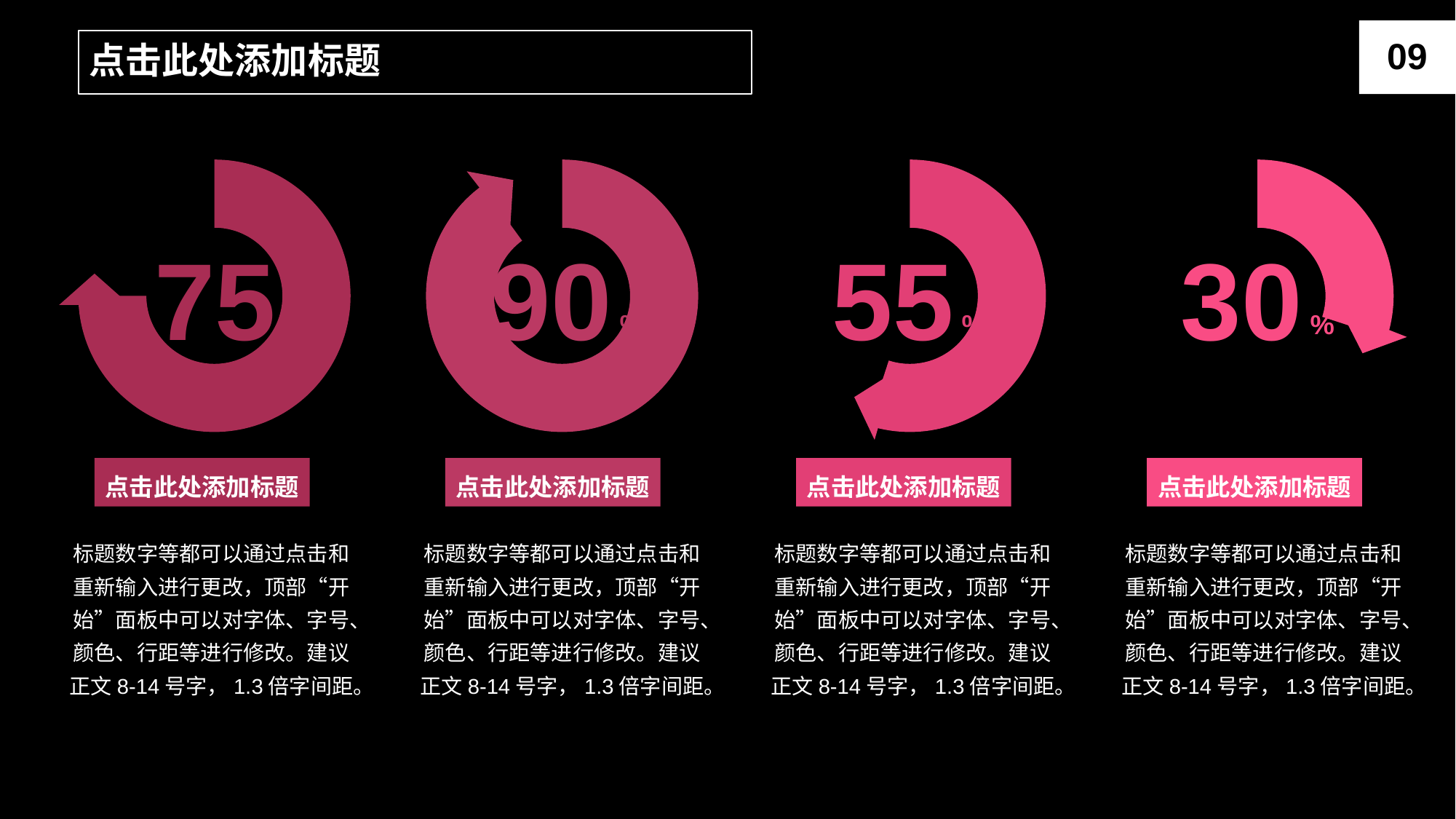
What value is shown in the second circular graphic from the left? 90% Which circular graphic shows the highest value? The second from the left (90%) Which is larger, the value in the third graphic or the value in the rightmost graphic? The third graphic (55%) Do the values decrease from the second graphic to the rightmost graphic? Yes, they fall from 90% to 55% to 30% What value is shown in the rightmost circular graphic? 30% What value is shown in the leftmost circular graphic? 75 How many circular percentage graphics are shown on the slide? 4 What page number is shown in the top-right corner of the slide? 09 What value is shown in the third circular graphic from the left? 55% What is the difference between the value in the second graphic (90%) and the value in the rightmost graphic (30%)? 60% Which circular graphic shows the lowest value? The rightmost (30%) What is the difference between the value in the leftmost graphic (75) and the value in the third graphic (55%)? 20